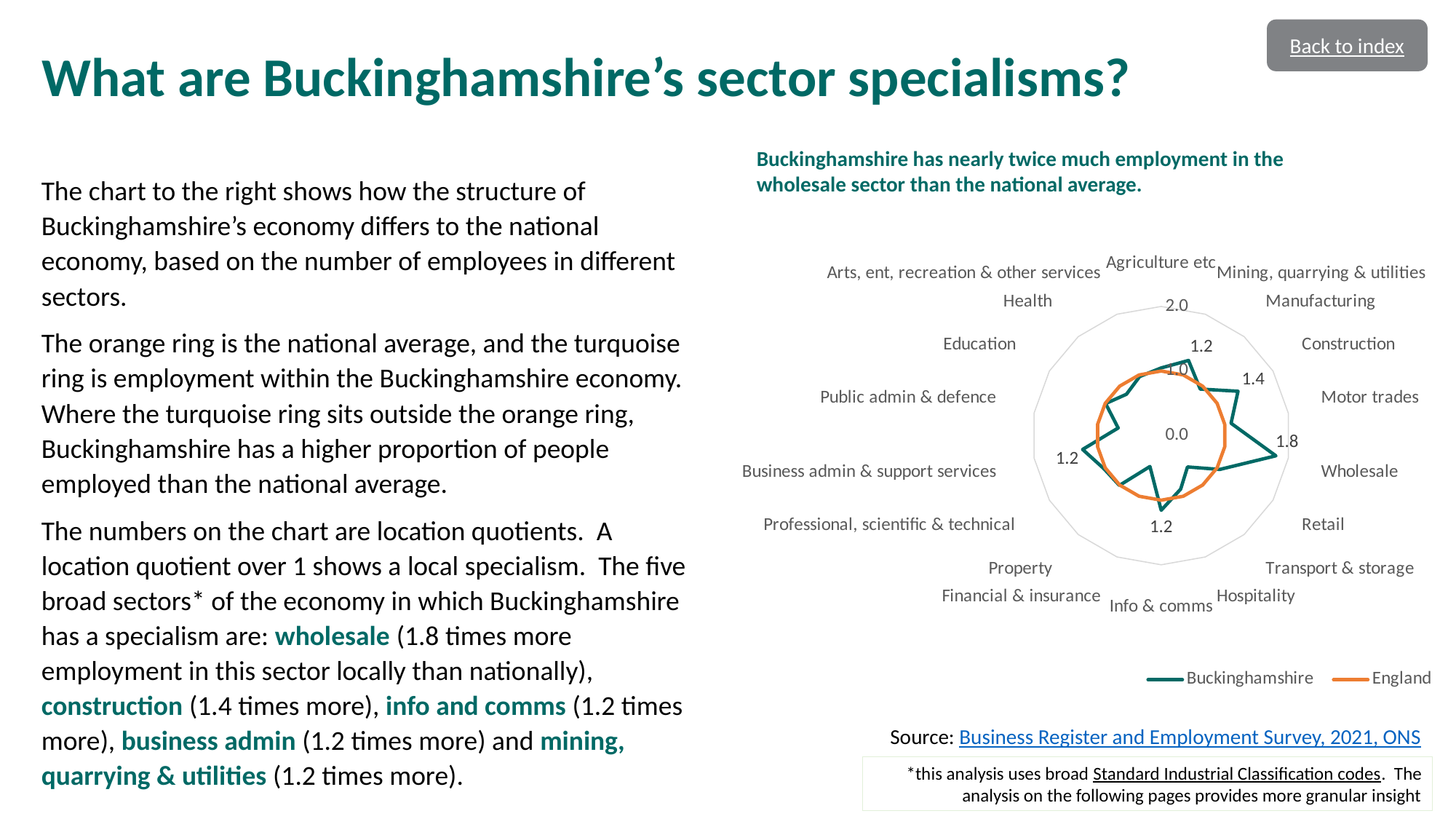
What is the Buckinghamshire location quotient for Business admin & support services? 1.2 How many sectors are plotted around the radar chart? 18 What kind of chart is shown on the slide? Radar chart Which sector has the highest Buckinghamshire location quotient? Wholesale Which has the larger Buckinghamshire location quotient, Wholesale or Construction? Wholesale What is the difference between the Buckinghamshire location quotients for Wholesale and Construction? 0.4 What is the Buckinghamshire location quotient for Construction? 1.4 What is the Buckinghamshire location quotient for Info & comms? 1.2 Which series is drawn in orange on the chart? England What is the Buckinghamshire location quotient for Mining, quarrying & utilities? 1.2 How many series does the chart's legend list? 2 What is the Buckinghamshire location quotient for Wholesale? 1.8